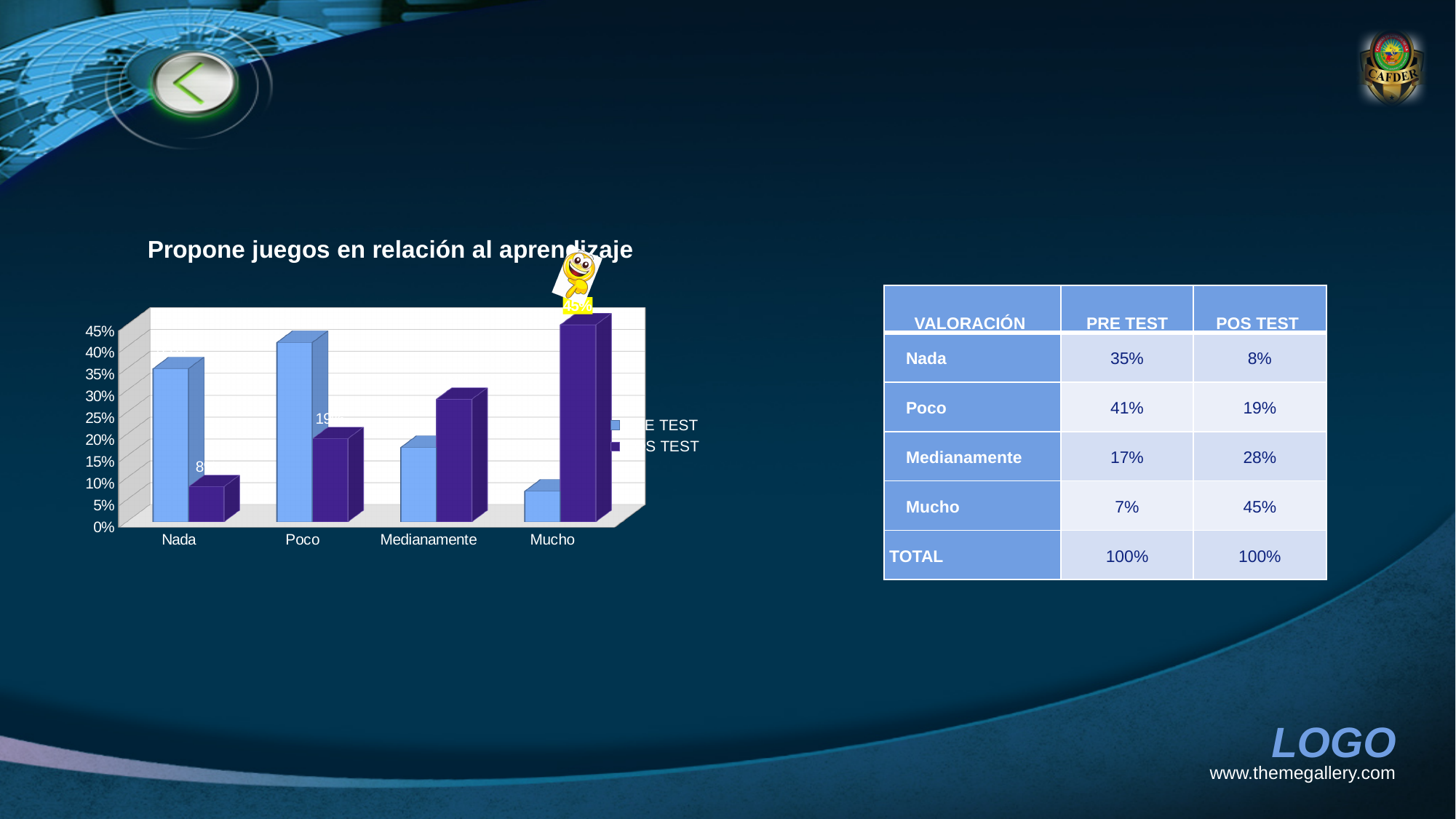
What kind of chart is shown on the slide? bar chart What is the POS TEST value for Mucho? 45% Which is larger for Medianamente, the PRE TEST value or the POS TEST value? POS TEST Which category has the lowest PRE TEST value? Mucho How many series does the chart's legend list? 2 Which category has the highest POS TEST value? Mucho What is the title of the chart? Propone juegos en relación al aprendizaje What is the difference between the POS TEST value for Mucho and the POS TEST value for Nada? 37% What is the POS TEST value for Poco? 19% Is the PRE TEST value for Poco greater or less than 40%? greater How many categories are shown on the x axis of the chart? 4 What is the PRE TEST value for Nada? 35%